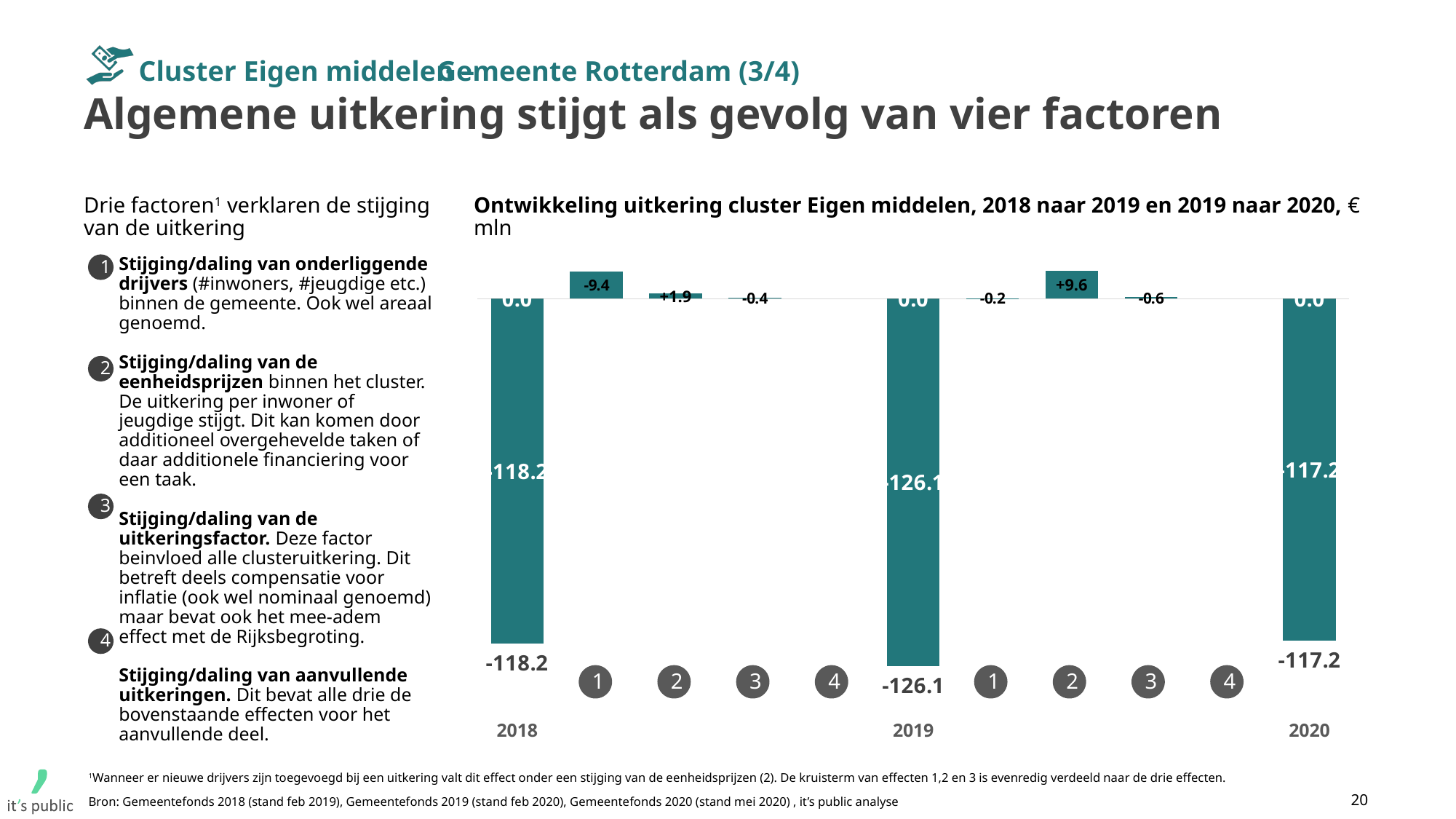
What is the effect of factor 2 on the change from 2019 to 2020? +9.6 What is the value of the uitkering for cluster Eigen middelen in 2019? -126.1 Is the effect of factor 2 from 2018 to 2019 larger or smaller than the effect of factor 2 from 2019 to 2020? smaller By how much does the uitkering value differ between 2018 and 2019? 7.9 Which year has the lowest (most negative) uitkering value: 2018, 2019 or 2020? 2019 What is the value of the uitkering for cluster Eigen middelen in 2018? -118.2 What is the effect of factor 1 on the change from 2019 to 2020? -0.2 What is the effect of factor 3 on the change from 2018 to 2019? -0.4 What unit is stated in the chart title? € mln How many years are shown as full bars in the chart? 3 What is the value of the uitkering for cluster Eigen middelen in 2020? -117.2 What is the effect of factor 1 on the change from 2018 to 2019? -9.4